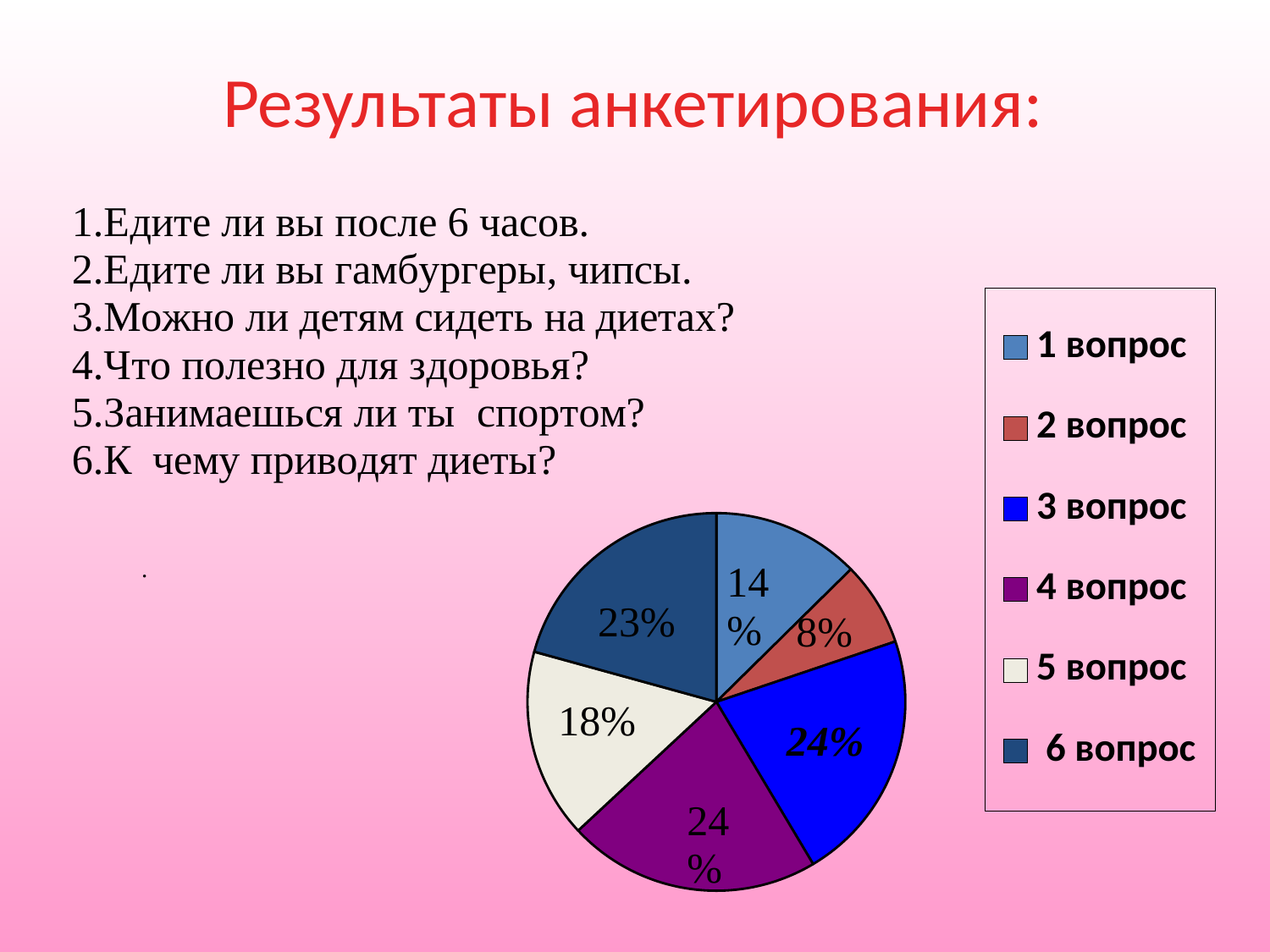
What share of the pie does "3 вопрос" have? 24% Which slice of the pie is the smallest? 2 вопрос How many entries does the legend list? 6 What share of the pie does "6 вопрос" have? 23% What share of the pie does "2 вопрос" have? 8% What kind of chart is shown on the slide? pie chart How many slices does the pie chart have? 6 What colour is the slice for "4 вопрос"? purple What is the difference between the shares for "6 вопрос" and "1 вопрос"? 9% Which is larger, the share for "6 вопрос" or the share for "5 вопрос"? 6 вопрос What share of the pie does "5 вопрос" have? 18% What share of the pie does "1 вопрос" have? 14%